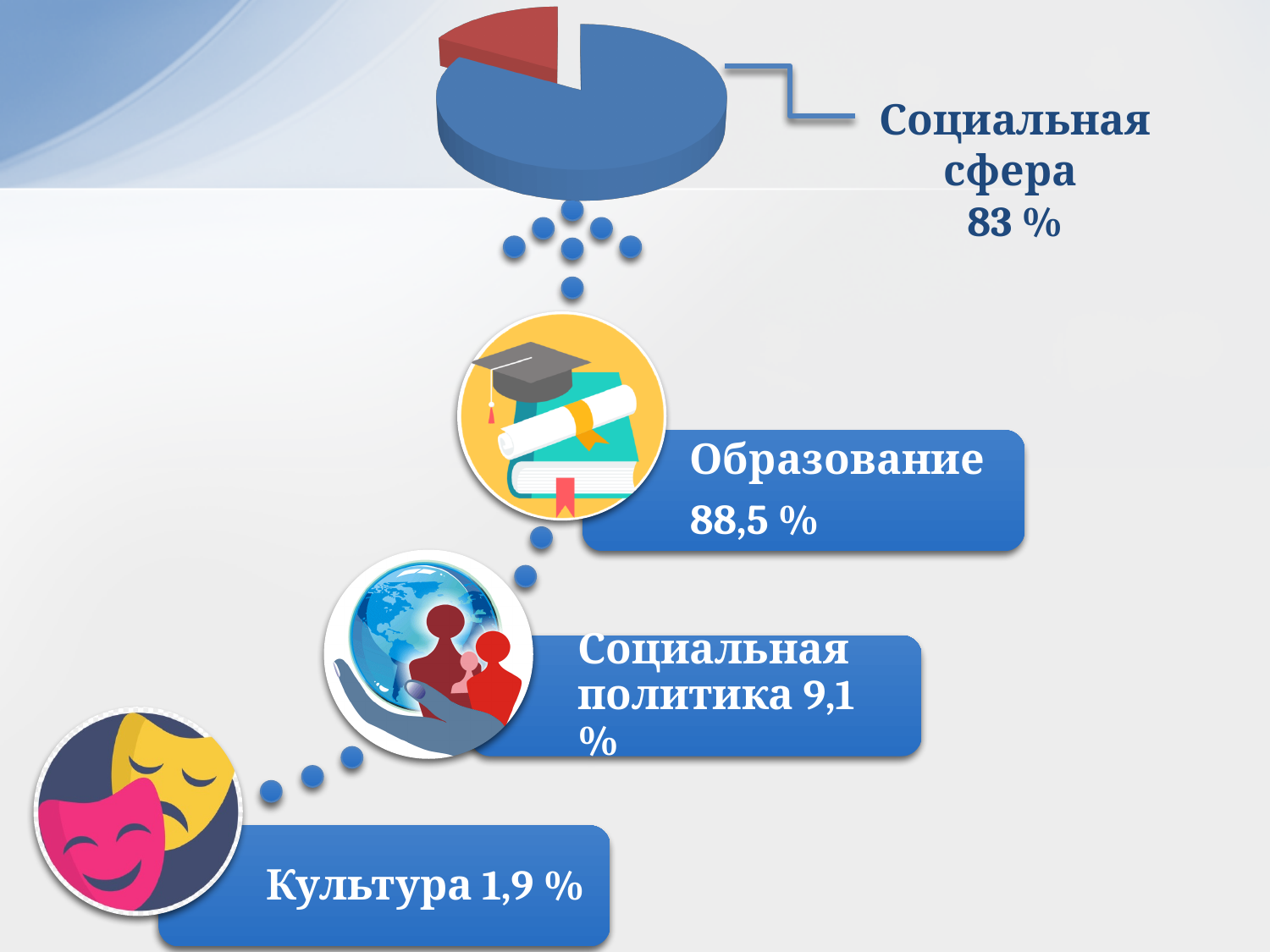
Which slice of the pie chart is the largest? Социальная сфера Which slice of the pie chart is pulled out (exploded) from the rest? the red slice Is the Социальная сфера slice larger or smaller than the red slice of the pie chart? larger What share of the pie chart does Социальная сфера represent? 83 % How many slices does the pie chart have? 2 What value is printed for Социальная сфера next to the pie chart? 83 % What kind of chart is shown at the top of the slide? pie chart What colour is the Социальная сфера slice in the pie chart? blue